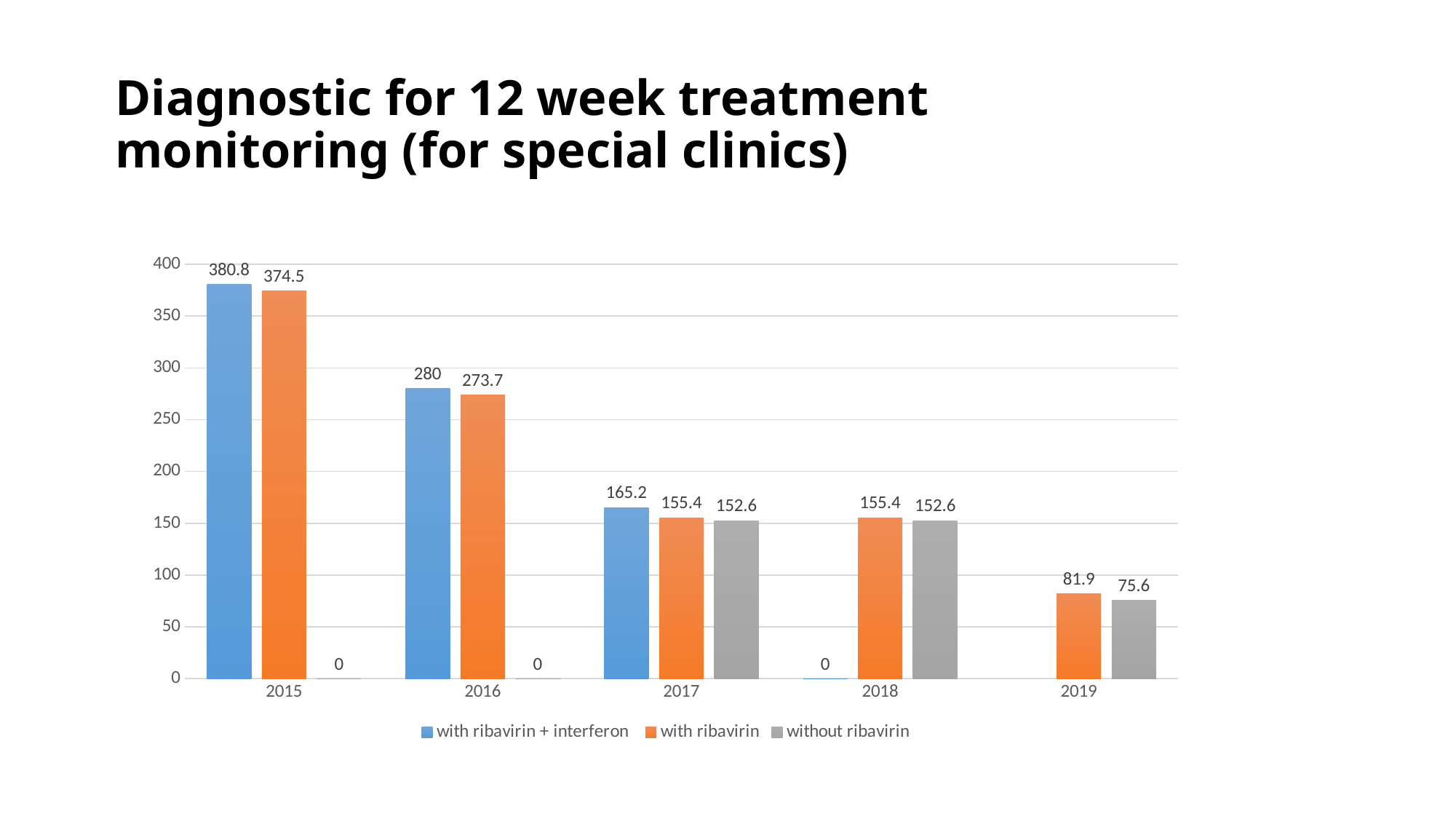
What is the value for 'with ribavirin' in 2016? 273.7 In which year is the 'with ribavirin' series highest? 2015 What is the value for 'with ribavirin + interferon' in 2018? 0 What is the value for 'with ribavirin + interferon' in 2015? 380.8 What kind of chart is shown on the slide? Bar chart What is the value for 'without ribavirin' in 2019? 75.6 Does the 'with ribavirin' series rise or fall from 2015 to 2019? Fall How many series does the legend list? 3 In which year is the 'with ribavirin' series lowest? 2019 How many years are shown on the x axis? 5 Which is larger in 2019: 'with ribavirin' or 'without ribavirin'? with ribavirin What is the difference between 'with ribavirin + interferon' and 'with ribavirin' in 2017? 9.8